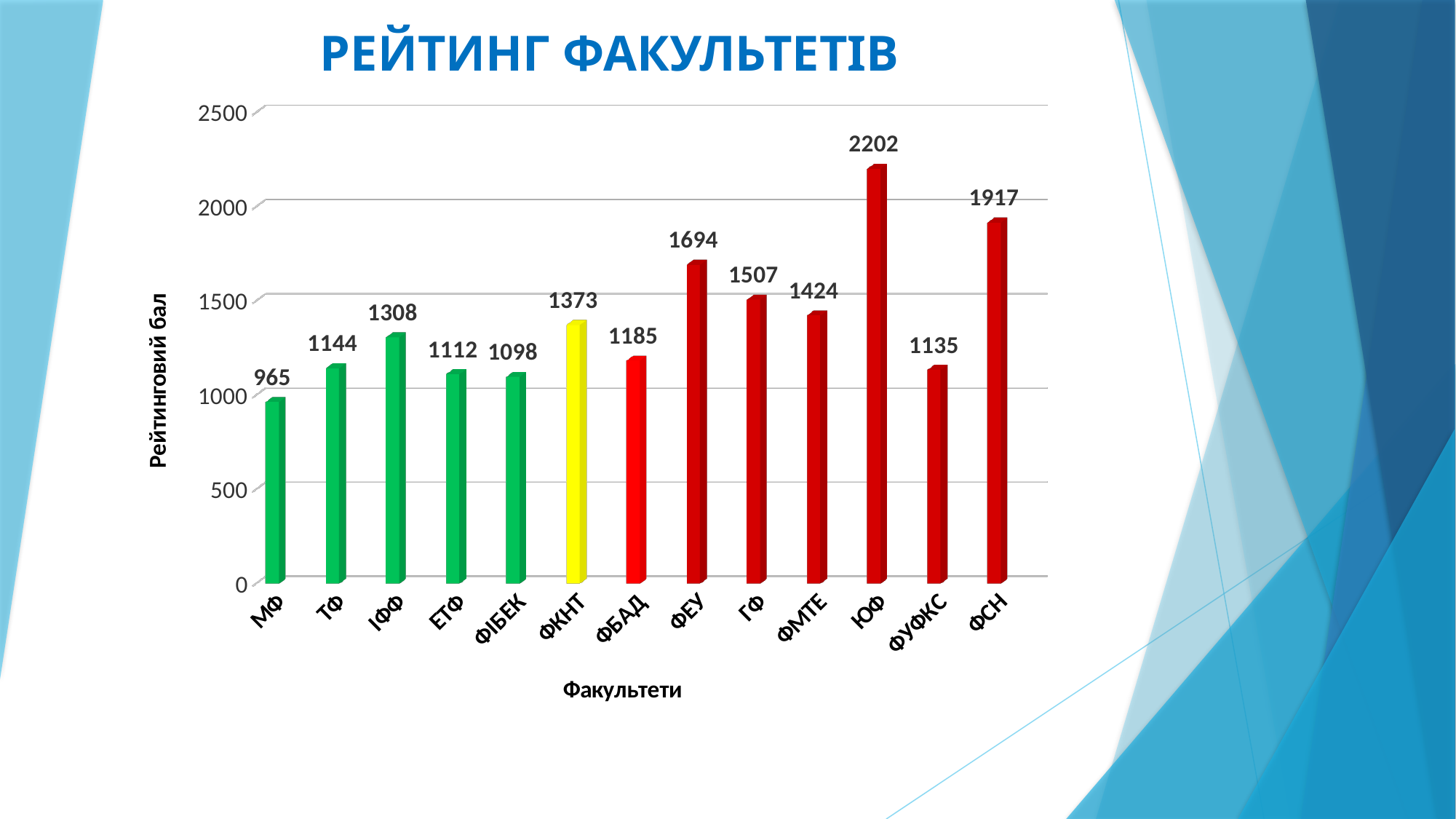
What is the rating score for ФУФКС? 1135 Which has a higher rating score, ІФФ or ТФ? ІФФ What is the difference between the rating scores of ЮФ and ФСН? 285 What is the difference between the rating scores of ФЕУ and ФБАД? 509 What kind of chart is shown on the slide? Bar chart What is the rating score for ФКНТ? 1373 Which faculty has the lowest rating score? МФ What is the rating score for ЮФ? 2202 How many faculties are shown on the chart? 13 Which faculty has the highest rating score? ЮФ Which has a higher rating score, ГФ or ФМТЕ? ГФ What is the title of the chart? РЕЙТИНГ ФАКУЛЬТЕТІВ